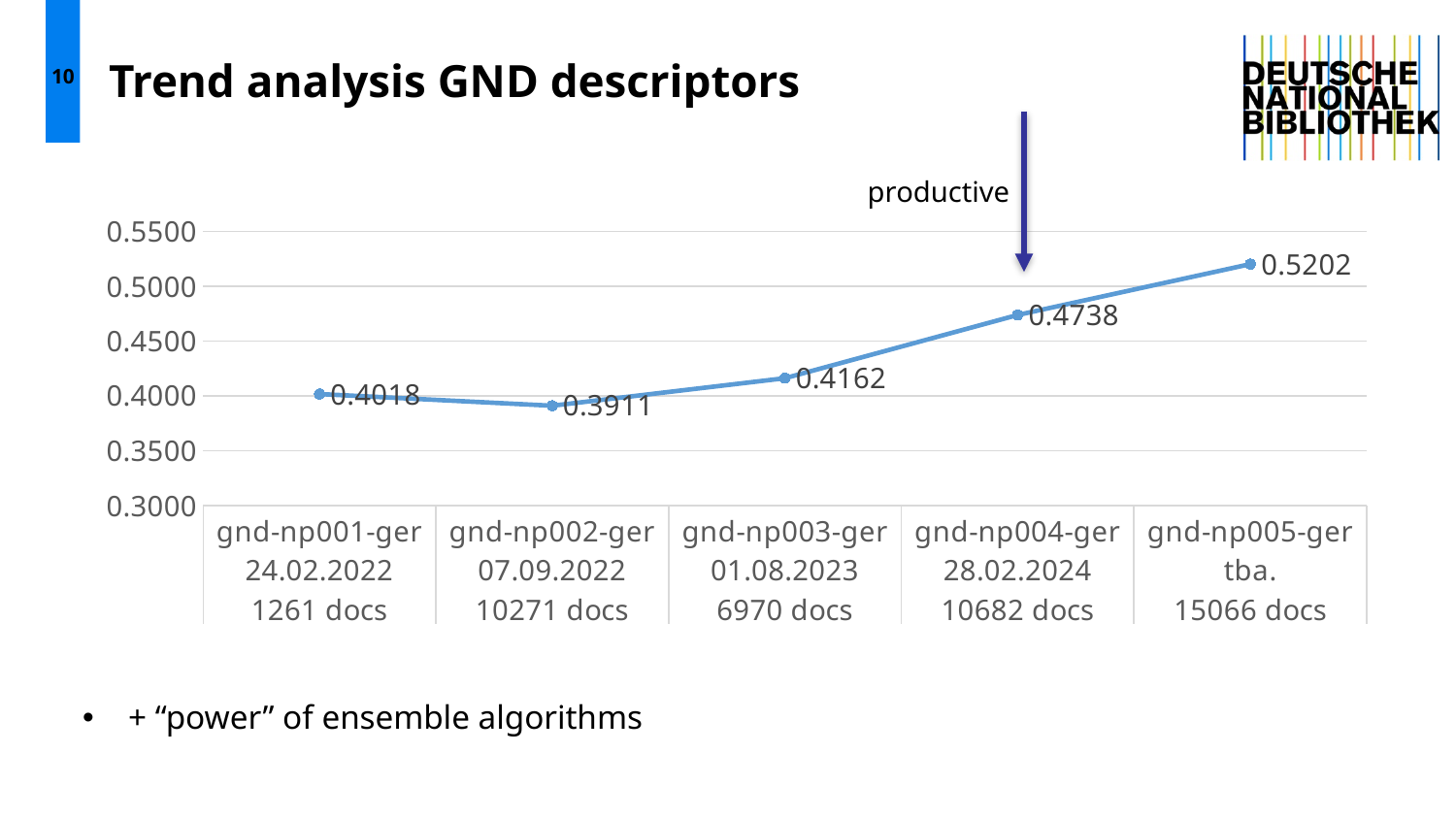
What is the difference between the values for gnd-np005-ger and gnd-np004-ger? 0.0464 Which category has the highest value? gnd-np005-ger How many data points are plotted on the chart? 5 What is the difference between the values for gnd-np001-ger and gnd-np002-ger? 0.0107 What is the value for gnd-np005-ger? 0.5202 Do the values rise or fall from gnd-np002-ger to gnd-np005-ger? rise Which is larger, the value for gnd-np003-ger or gnd-np004-ger? gnd-np004-ger Is the value for gnd-np004-ger greater or less than 0.4500? greater What is the value for gnd-np003-ger? 0.4162 What is the value for gnd-np001-ger? 0.4018 What kind of chart is shown on the slide? line chart Which category has the lowest value? gnd-np002-ger